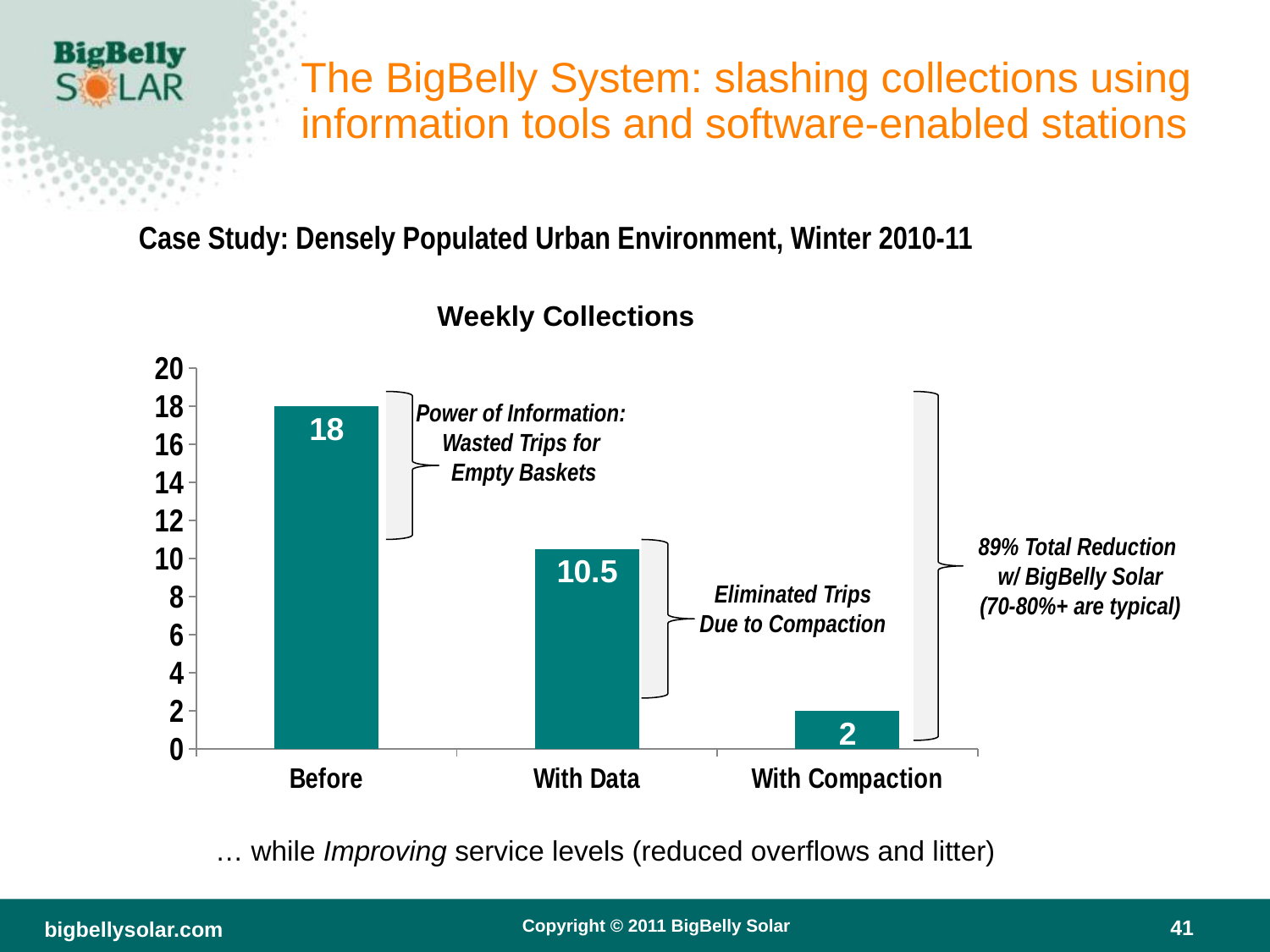
What is the value for With Compaction in the Weekly Collections chart? 2 Which category has the lowest weekly collections? With Compaction What is the value for Before in the Weekly Collections chart? 18 What is the difference between the With Data and With Compaction values? 8.5 Which category has the highest weekly collections? Before What is the title of the chart? Weekly Collections What is the difference between the Before and With Data values? 7.5 Which is larger, the value for With Data or the value for With Compaction? With Data Do the values rise or fall from left to right along the x axis? Fall How many categories are shown on the x axis of the chart? 3 What kind of chart is shown on the slide? Bar chart What is the value for With Data in the Weekly Collections chart? 10.5